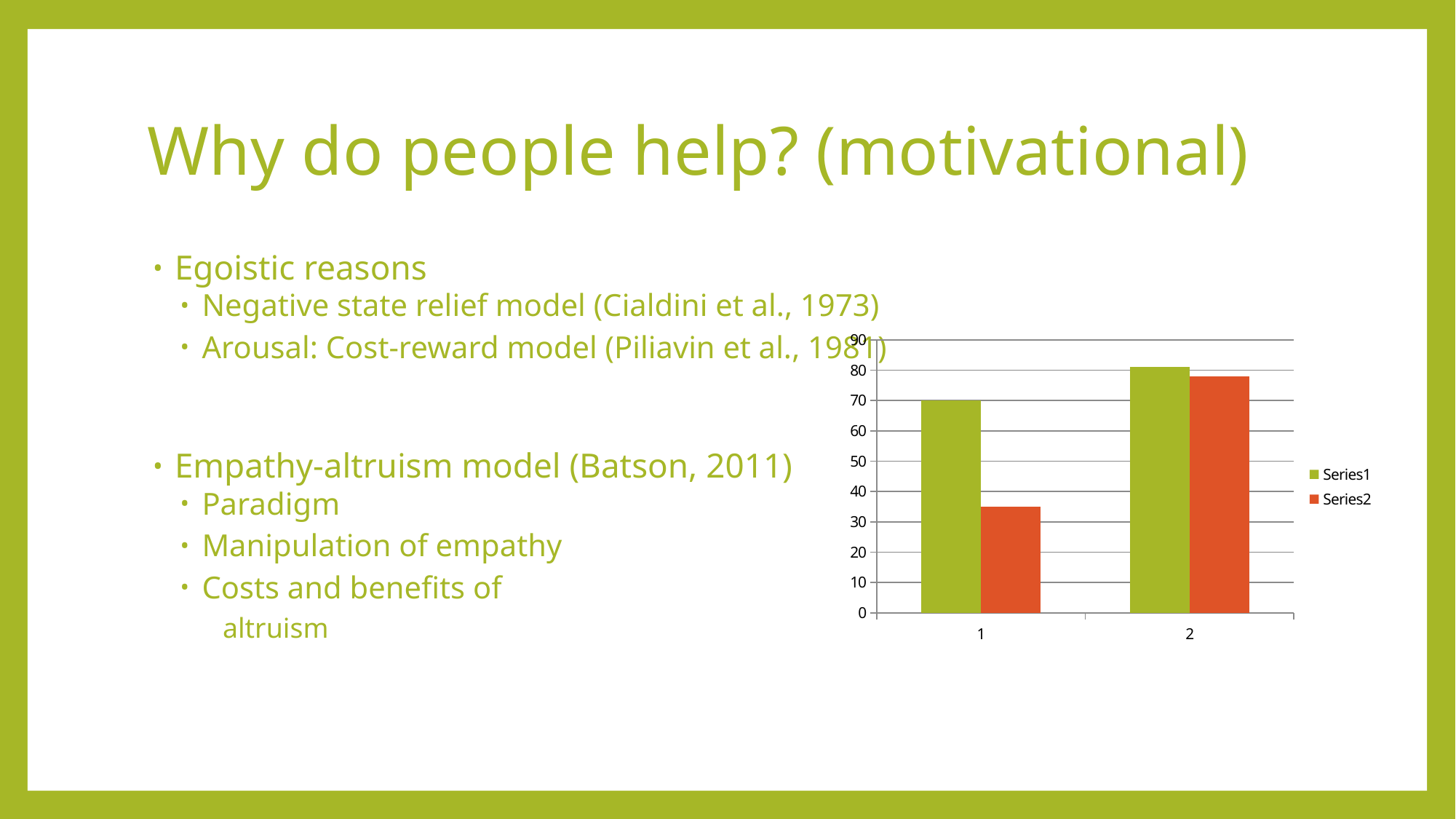
Is the value for Series2 at category 1 greater or less than 40? less Is the value for Series1 at category 2 greater or less than 70? greater What are the entries listed in the chart's legend? Series1, Series2 Which bar in the chart is the lowest? Series2 at category 1 Is the value for Series2 at category 1 greater or less than 30? greater How many categories are shown on the x axis of the chart? 2 How many series does the chart's legend list? 2 For Series2, which category has the higher value? 2 Does the value for Series2 rise or fall from category 1 to category 2? rise At category 1, which series has the larger value, Series1 or Series2? Series1 What kind of chart is shown on the slide? bar chart